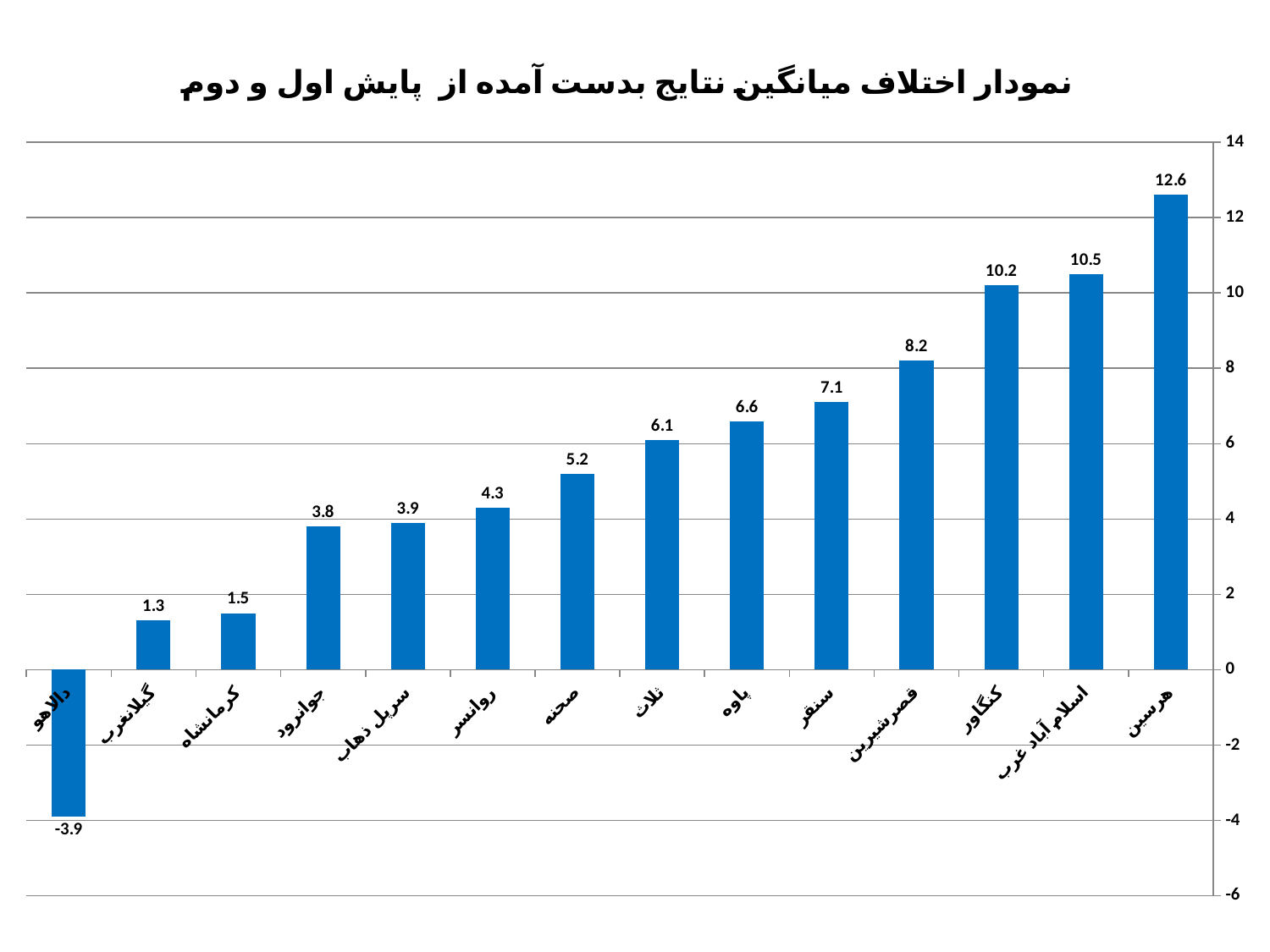
What is the difference between the values for اسلام آباد غرب and کنگاور? 0.3 Which category has the highest value? هرسین What is the value for کرمانشاه? 1.5 Which is larger, the value for پاوه or the value for صحنه? پاوه What kind of chart is shown on the slide? bar chart How many bars have a negative value? 1 What is the value for هرسین? 12.6 Which category has the lowest value? دالاهو What is the value for قصرشیرین? 8.2 Do the values generally rise or fall from left to right along the x axis? rise How many categories are shown on the x axis? 14 What is the value for دالاهو? -3.9